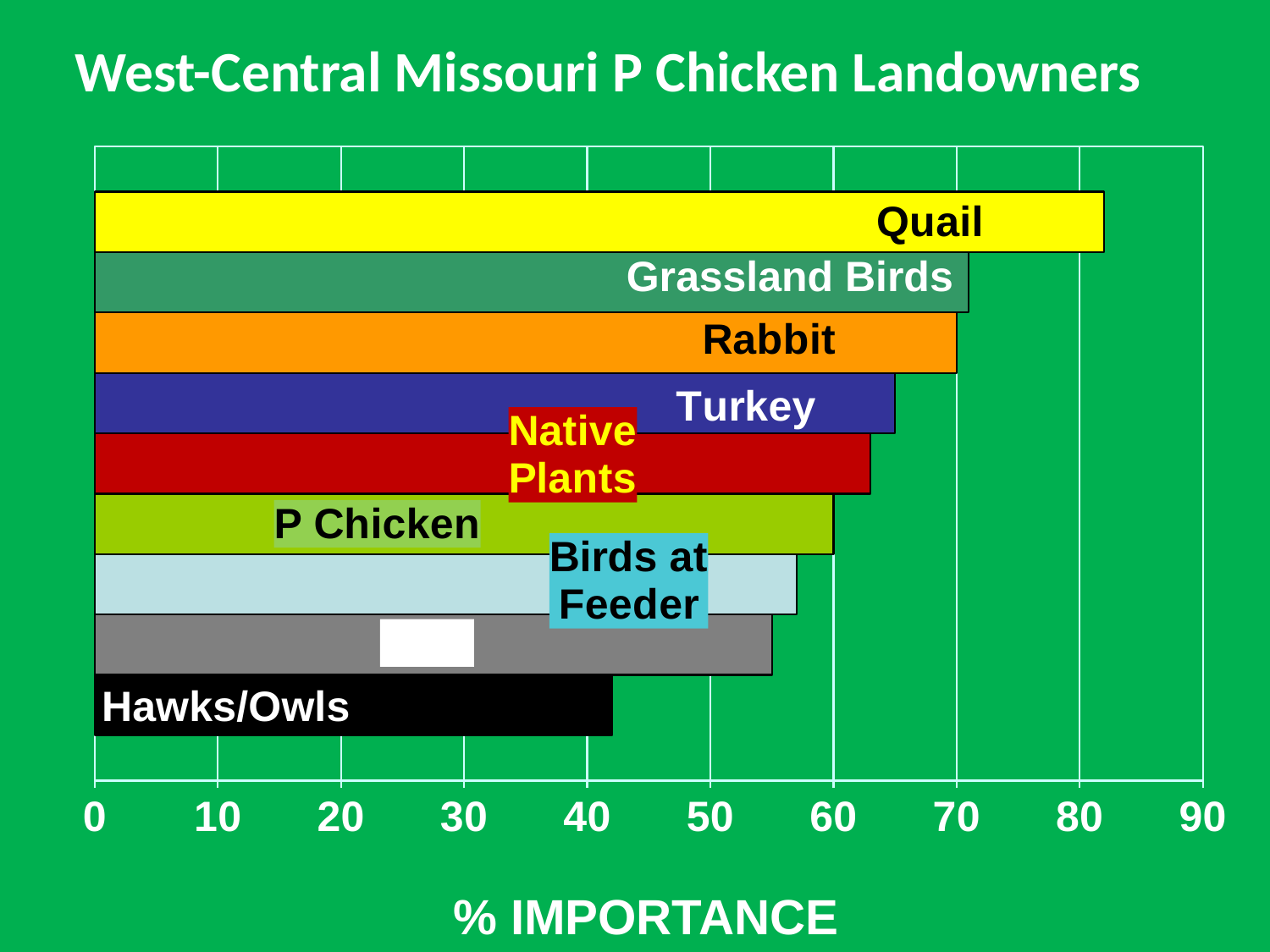
What is the title of the chart? West-Central Missouri P Chicken Landowners Is the value for Hawks/Owls greater or less than 50? less Which category has the lowest % importance? Hawks/Owls What kind of chart is shown on the slide? bar chart How many bars are plotted in the chart? 9 Is the value for Quail greater or less than 80? greater Is the value for Birds at Feeder greater or less than 60? less Which has a higher % importance, Quail or Turkey? Quail Which category has the highest % importance? Quail What is the label on the horizontal axis? % IMPORTANCE Which has a higher % importance, Rabbit or P Chicken? Rabbit